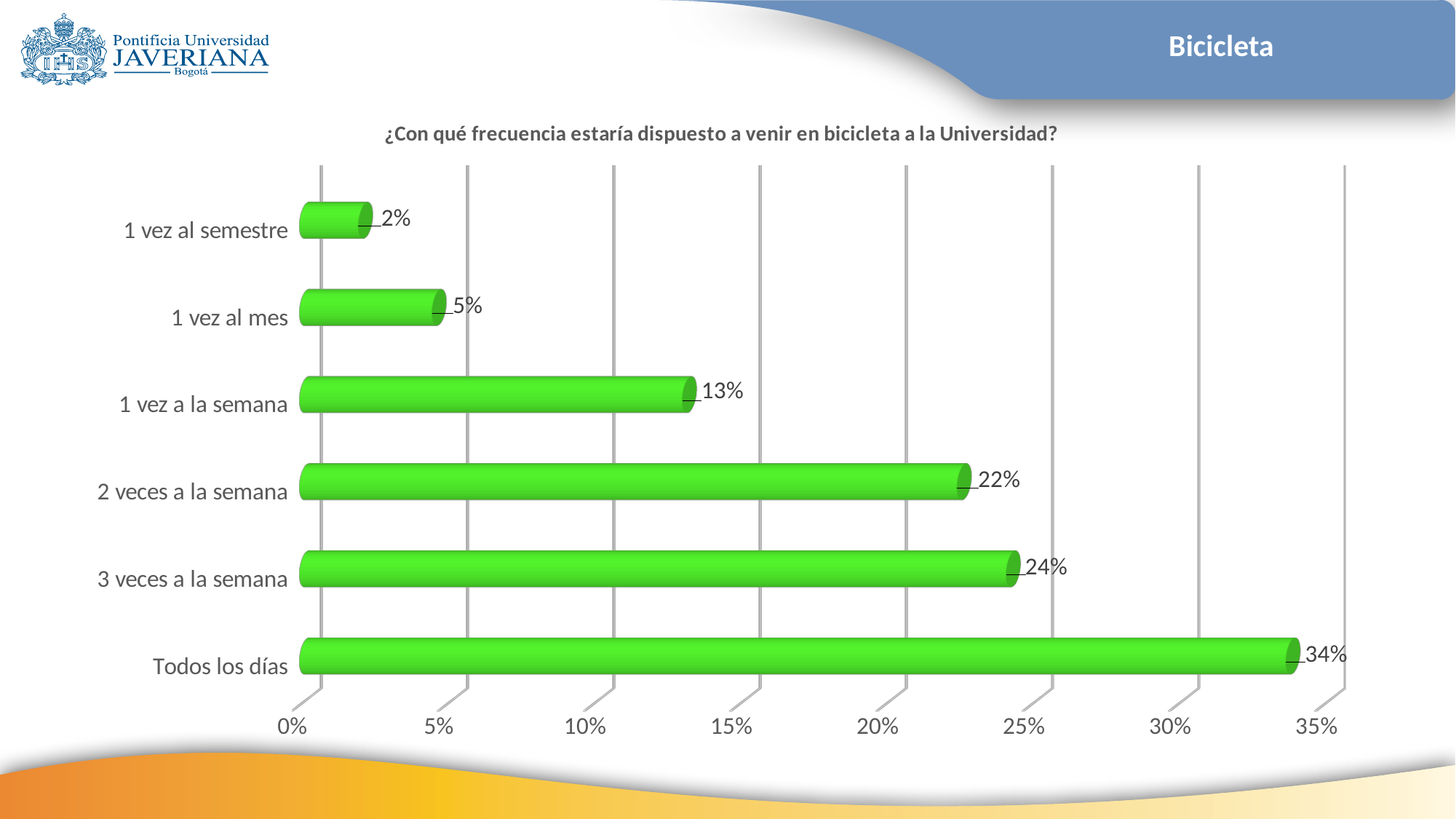
What is the value for "1 vez a la semana"? 13% What is the value for "Todos los días"? 34% Is the value for "2 veces a la semana" greater or less than 20%? greater Which category has the lowest value? 1 vez al semestre What is the difference between the values for "2 veces a la semana" and "1 vez a la semana"? 9% What is the value for "1 vez al mes"? 5% How many categories are shown in the chart? 6 What is the title of the chart? ¿Con qué frecuencia estaría dispuesto a venir en bicicleta a la Universidad? Which is larger, the value for "3 veces a la semana" or "2 veces a la semana"? 3 veces a la semana Which category has the highest value? Todos los días What is the difference between the values for "Todos los días" and "3 veces a la semana"? 10% What kind of chart is shown on the slide? Bar chart